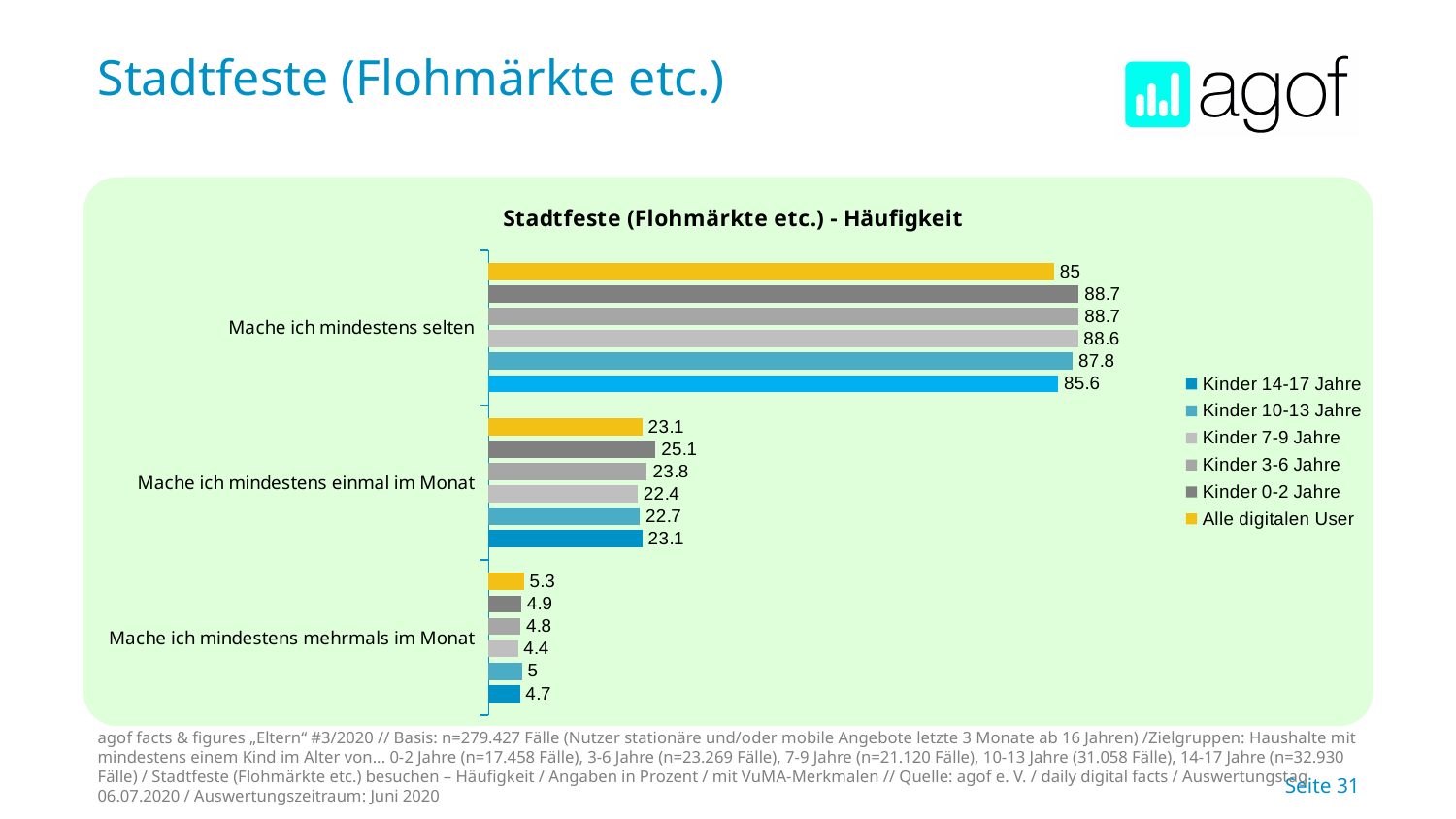
What is the value for Kinder 10-13 Jahre in the category 'Mache ich mindestens selten'? 87.8 What is the title of the chart? Stadtfeste (Flohmärkte etc.) - Häufigkeit What is the difference between Kinder 0-2 Jahre and Alle digitalen User in the category 'Mache ich mindestens selten'? 3.7 In the category 'Mache ich mindestens mehrmals im Monat', which is larger: Alle digitalen User or Kinder 10-13 Jahre? Alle digitalen User How many series does the legend list? 6 What is the value for Alle digitalen User in the category 'Mache ich mindestens selten'? 85 What is the value for Kinder 7-9 Jahre in the category 'Mache ich mindestens mehrmals im Monat'? 4.4 What is the value for Kinder 14-17 Jahre in the category 'Mache ich mindestens einmal im Monat'? 23.1 How many categories are shown on the vertical axis? 3 Which series has the highest value in the category 'Mache ich mindestens einmal im Monat'? Kinder 0-2 Jahre What type of chart is shown on the slide? bar chart Which series has the lowest value in the category 'Mache ich mindestens mehrmals im Monat'? Kinder 7-9 Jahre